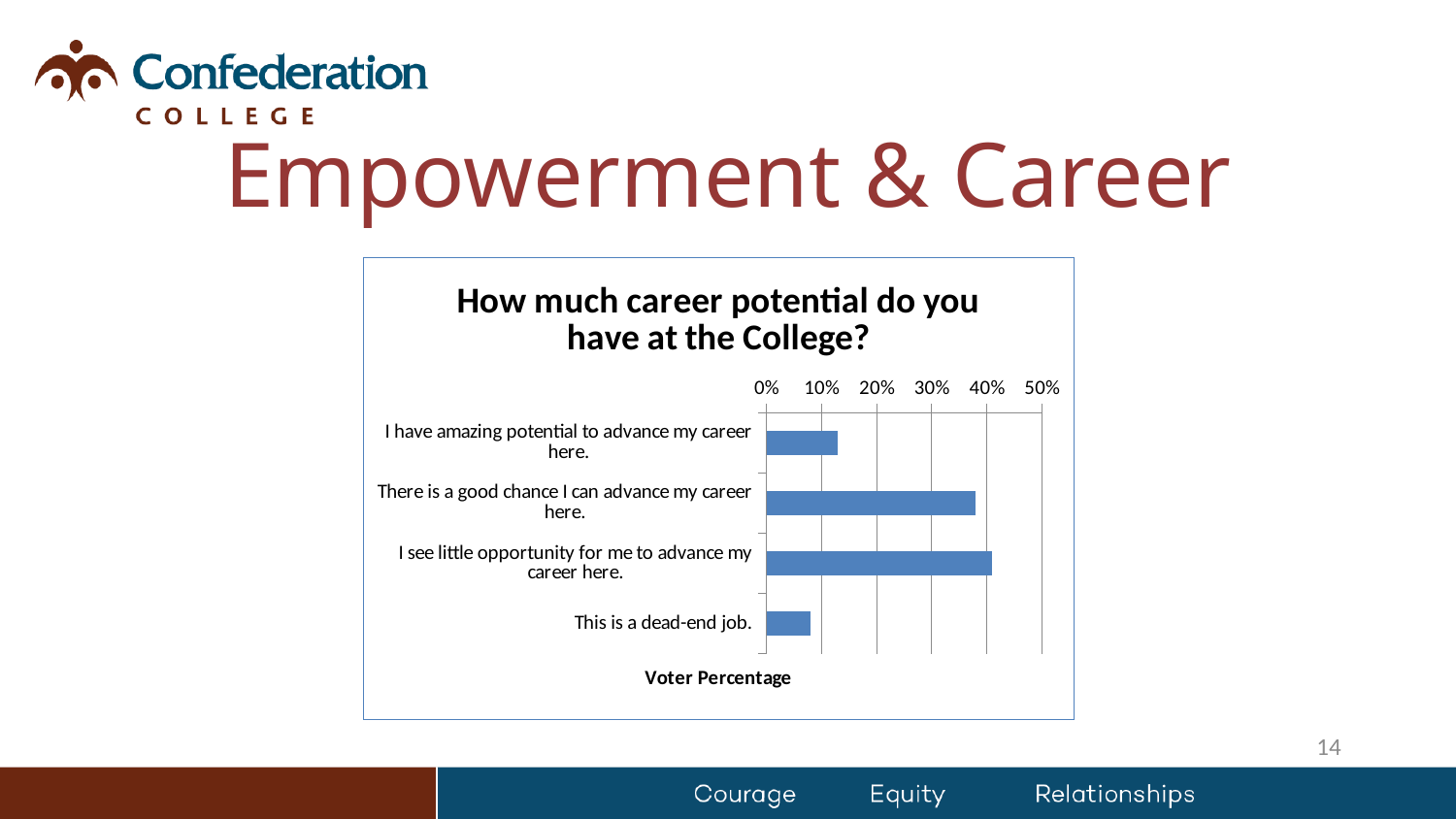
What is the title of the chart? How much career potential do you have at the College? What kind of chart is shown on the slide? bar chart Which response category has the lowest voter percentage? This is a dead-end job. Which response category has the highest voter percentage? I see little opportunity for me to advance my career here. Is the value for "This is a dead-end job." greater or less than 10%? less Is the value for "There is a good chance I can advance my career here." greater or less than 30%? greater What is the label of the value axis in the chart? Voter Percentage Is the value for "I see little opportunity for me to advance my career here." greater or less than 30%? greater Which has a larger voter percentage: "There is a good chance I can advance my career here." or "I have amazing potential to advance my career here."? There is a good chance I can advance my career here. Which has a larger voter percentage: "I have amazing potential to advance my career here." or "This is a dead-end job."? I have amazing potential to advance my career here. How many response categories are plotted in the chart? 4